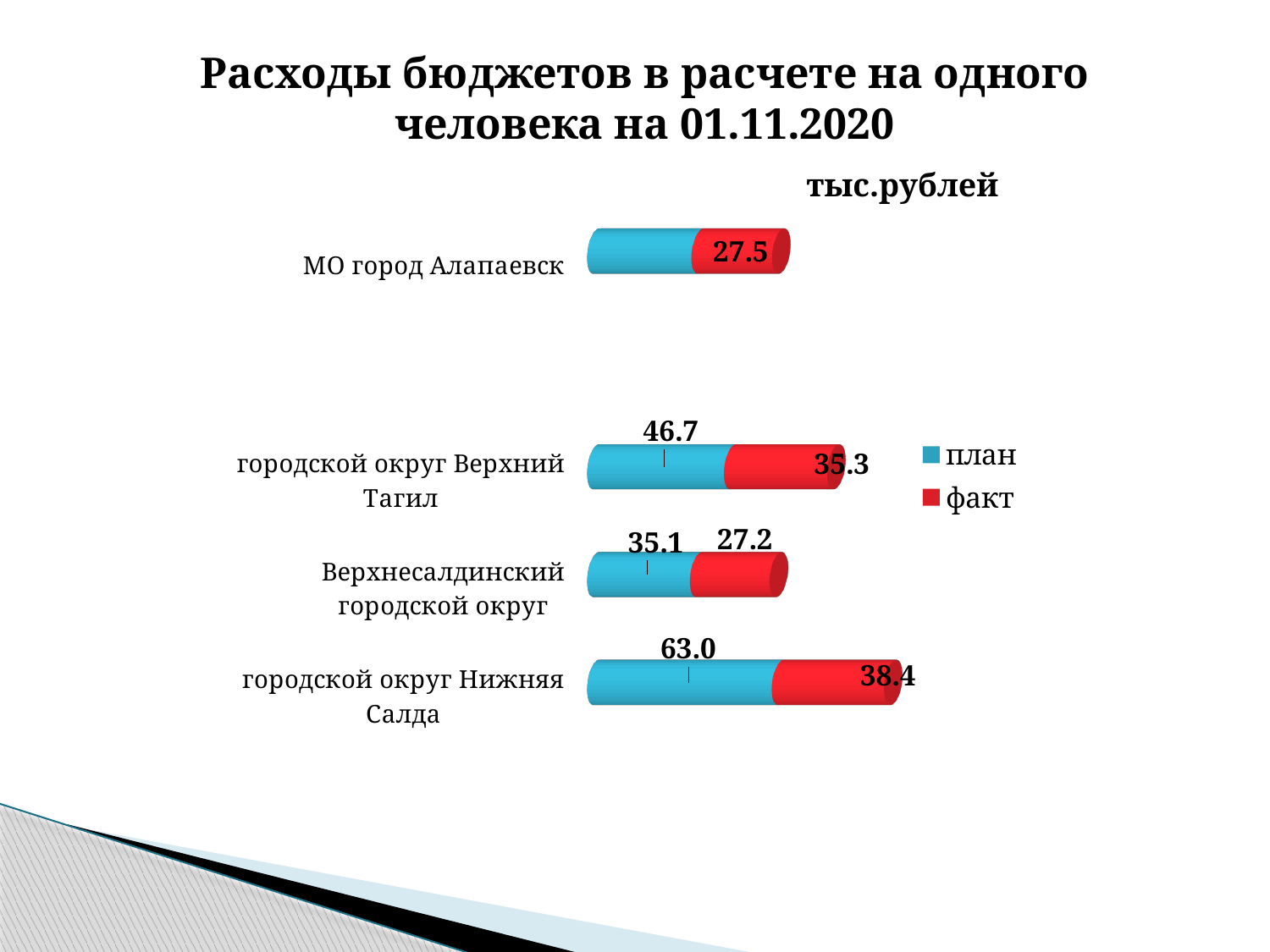
What is the difference between the план and факт values for городской округ Нижняя Салда? 24.6 What is the план value for городской округ Верхний Тагил? 46.7 Which category has the highest план value? городской округ Нижняя Салда Which category has the highest факт value? городской округ Нижняя Салда What is the факт value for МО город Алапаевск? 27.5 What is the факт value for городской округ Нижняя Салда? 38.4 What is the difference between the план and факт values for городской округ Верхний Тагил? 11.4 Which has the larger план value: городской округ Верхний Тагил or Верхнесалдинский городской округ? городской округ Верхний Тагил How many categories are shown in the chart? 4 What kind of chart is shown on the slide? bar chart How many series does the legend list? 2 What is the план value for Верхнесалдинский городской округ? 35.1